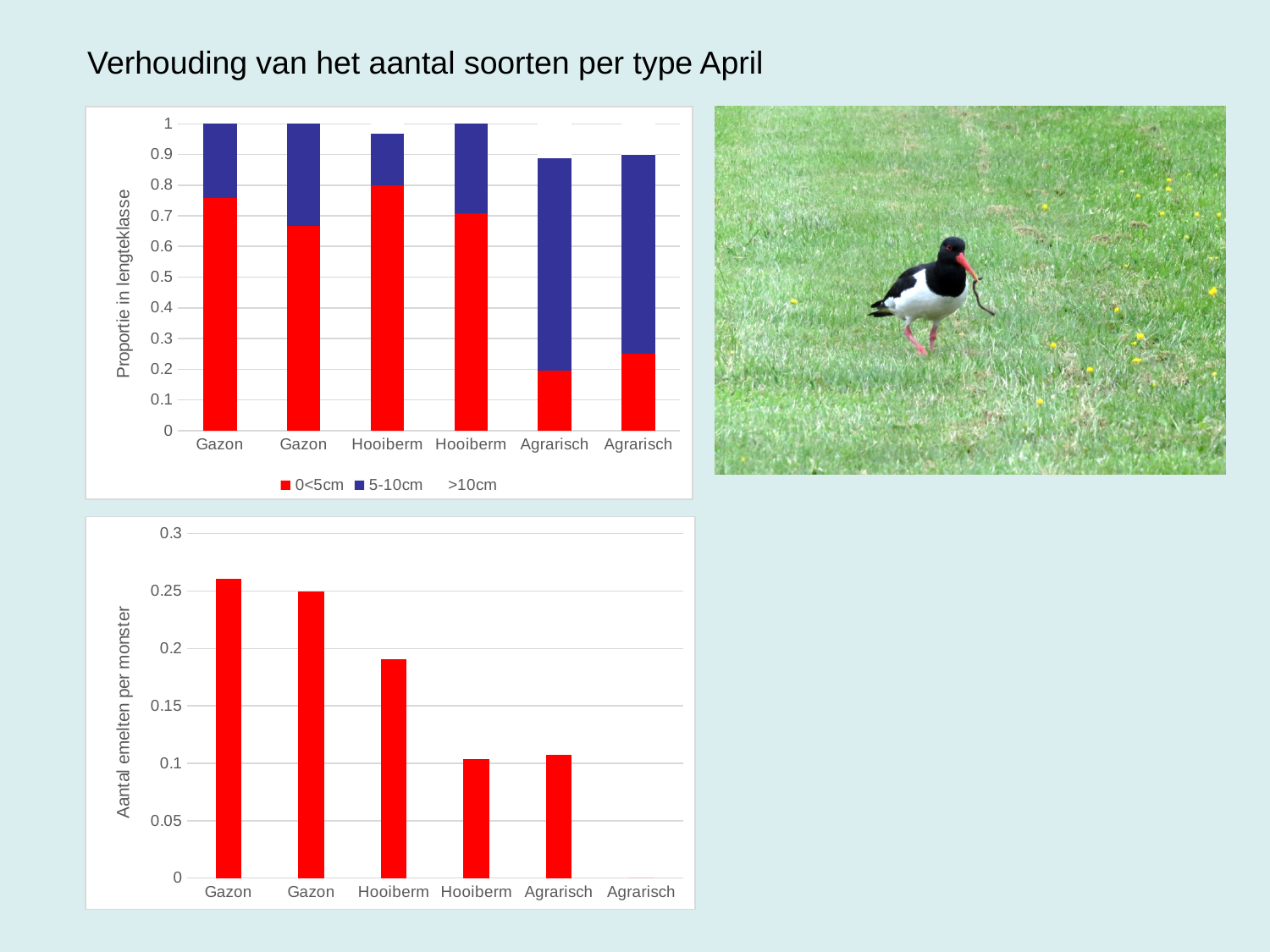
In the top-left chart, is the 0<5cm value for the first Agrarisch bar greater or less than 0.3? less How many series does the legend of the top-left chart list? 3 In the bottom-left chart, do the bar values generally rise or fall from left to right along the x axis? fall In the top-left chart, which has the larger 0<5cm segment: the first Hooiberm bar or the second Hooiberm bar? the first Hooiberm bar What is the y-axis label of the bottom-left chart? Aantal emelten per monster In the bottom-left chart, is the value for the first Hooiberm bar greater or less than 0.15? greater In the bottom-left chart, is the value for the first Agrarisch bar greater or less than 0.15? less What kind of chart is the top-left chart on the slide? stacked bar chart In the bottom-left chart, which category has the highest bar? the first Gazon How many categories are shown on the x axis of the top-left chart? 6 In the top-left chart, which colour represents the 0<5cm series? red